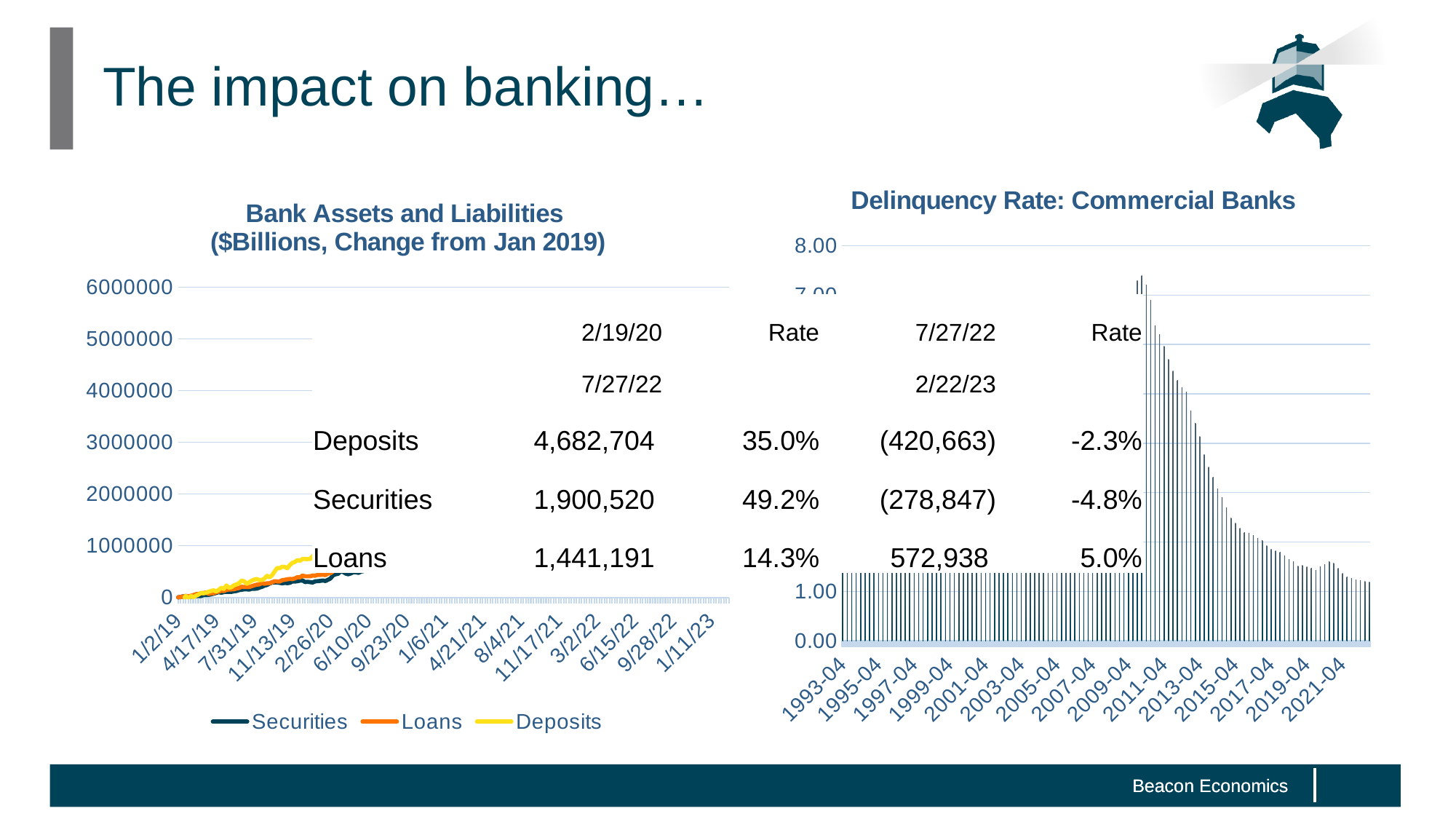
In the 'Bank Assets and Liabilities' chart, is the Deposits value at 2/26/20 greater or less than 1000000? less In the 'Delinquency Rate: Commercial Banks' chart, is the peak delinquency rate greater or less than 8.00? less What type of chart is the 'Bank Assets and Liabilities' chart on the left? Line chart In the 'Delinquency Rate: Commercial Banks' chart, does the delinquency rate rise or fall from 2011-04 to 2021-04? fall In the 'Bank Assets and Liabilities' chart, which series has the highest value at the end of the plotted lines (around 2/26/20)? Deposits In the 'Bank Assets and Liabilities' chart, which series has the lowest value at the end of the plotted lines (around 2/26/20)? Securities In the 'Delinquency Rate: Commercial Banks' chart, is the delinquency rate at 2021-04 greater or less than 1.00? greater In the 'Bank Assets and Liabilities' chart, do the Deposits values rise or fall from 1/2/19 to 2/26/20? rise Which series are listed in the legend of the 'Bank Assets and Liabilities' chart? Securities, Loans, Deposits What type of chart is the 'Delinquency Rate: Commercial Banks' chart on the right? Bar chart What is the highest value shown on the y-axis of the 'Delinquency Rate: Commercial Banks' chart? 8.00 How many series does the legend of the 'Bank Assets and Liabilities' chart list? 3